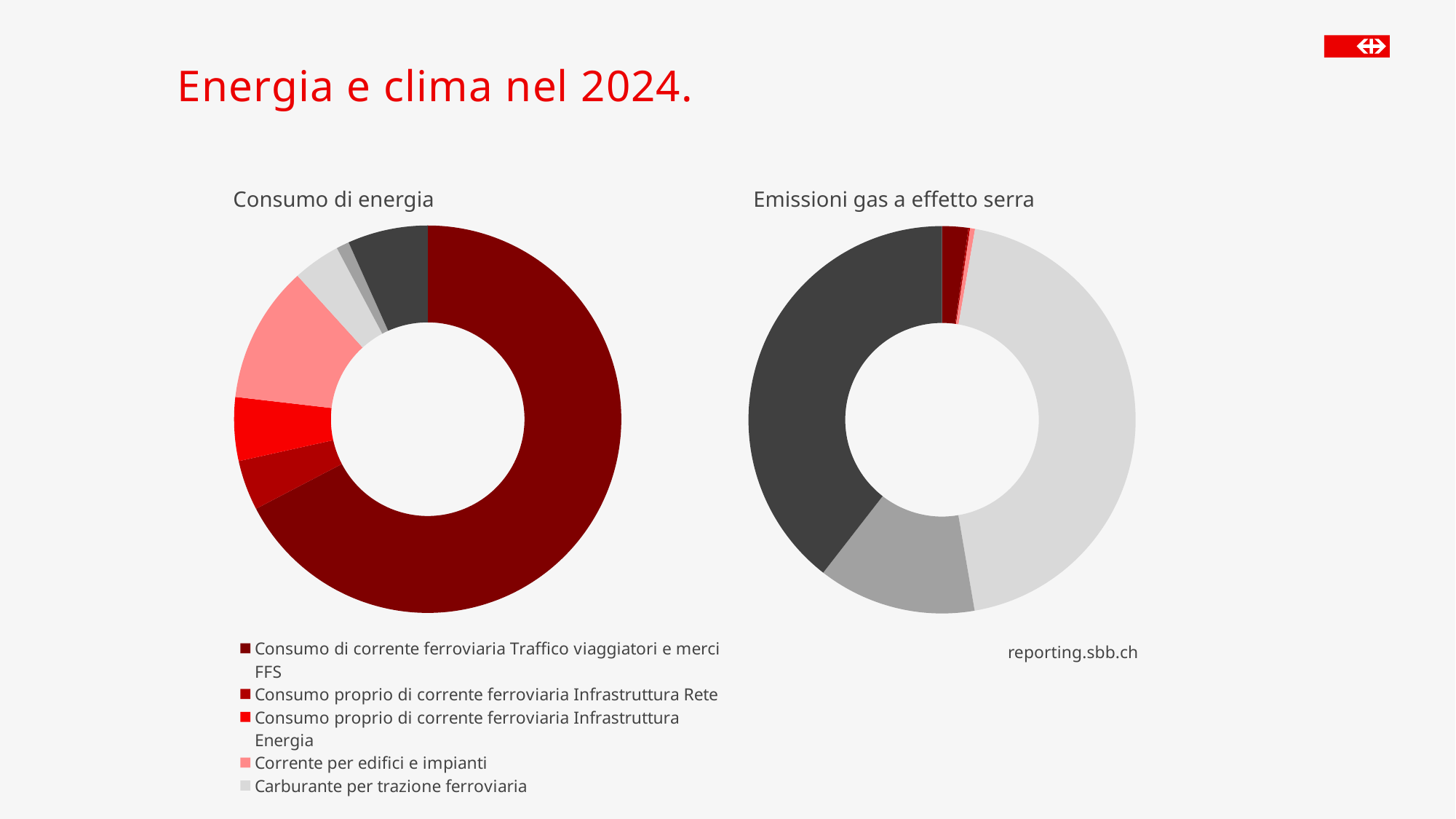
In the "Consumo di energia" chart, which is larger: "Corrente per edifici e impianti" or "Consumo proprio di corrente ferroviaria Infrastruttura Energia"? Corrente per edifici e impianti What source is cited below the "Emissioni gas a effetto serra" chart? reporting.sbb.ch In the "Consumo di energia" chart, which is larger: "Consumo proprio di corrente ferroviaria Infrastruttura Rete" or "Consumo di corrente ferroviaria Traffico viaggiatori e merci FFS"? Consumo di corrente ferroviaria Traffico viaggiatori e merci FFS How many entries does the legend of the "Consumo di energia" chart list? 5 What kind of chart is the "Emissioni gas a effetto serra" chart? Doughnut chart In the "Consumo di energia" chart, which is larger: "Corrente per edifici e impianti" or "Carburante per trazione ferroviaria"? Corrente per edifici e impianti In the "Consumo di energia" chart, which category has the largest slice? Consumo di corrente ferroviaria Traffico viaggiatori e merci FFS How many charts are shown on the slide? 2 What kind of chart is the "Consumo di energia" chart? Doughnut chart What is the title of the chart on the right of the slide? Emissioni gas a effetto serra